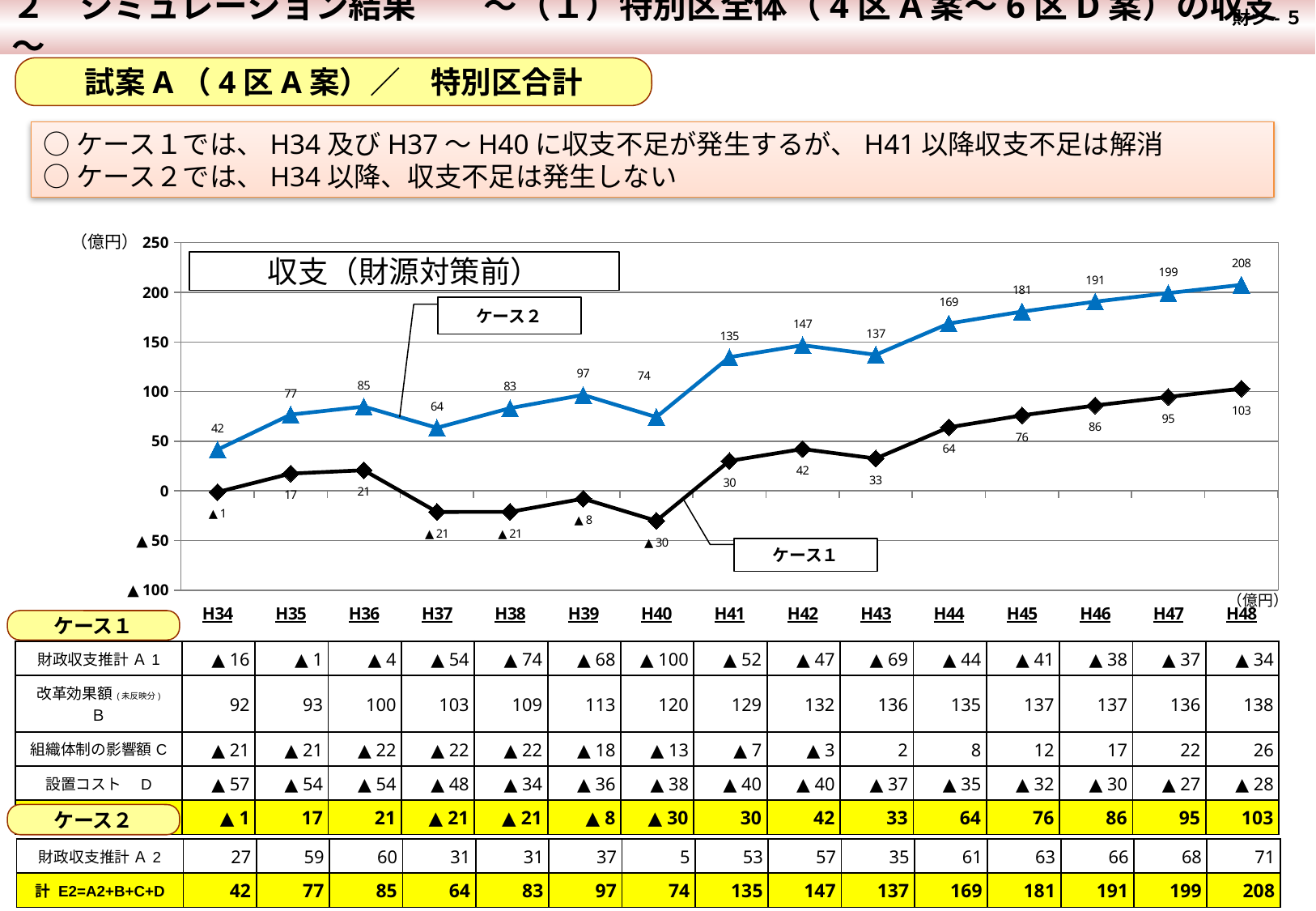
Which is larger at H43: the value for ケース2 or the value for ケース1? ケース2 At which year does ケース2 reach its highest value? H48 At which year does ケース1 reach its lowest value? H40 What type of chart is shown on the slide? line chart What is the difference between ケース2 and ケース1 at H42? 105 What is the title shown inside the chart area? 収支（財源対策前） What is the value for ケース2 at H37? 64 What is the value for ケース1 at H44? 64 How many years (x-axis categories) are plotted in the chart? 15 How many series are plotted in the chart? 2 What is the value for ケース1 at H40? ▲30 What is the value for ケース2 at H48? 208